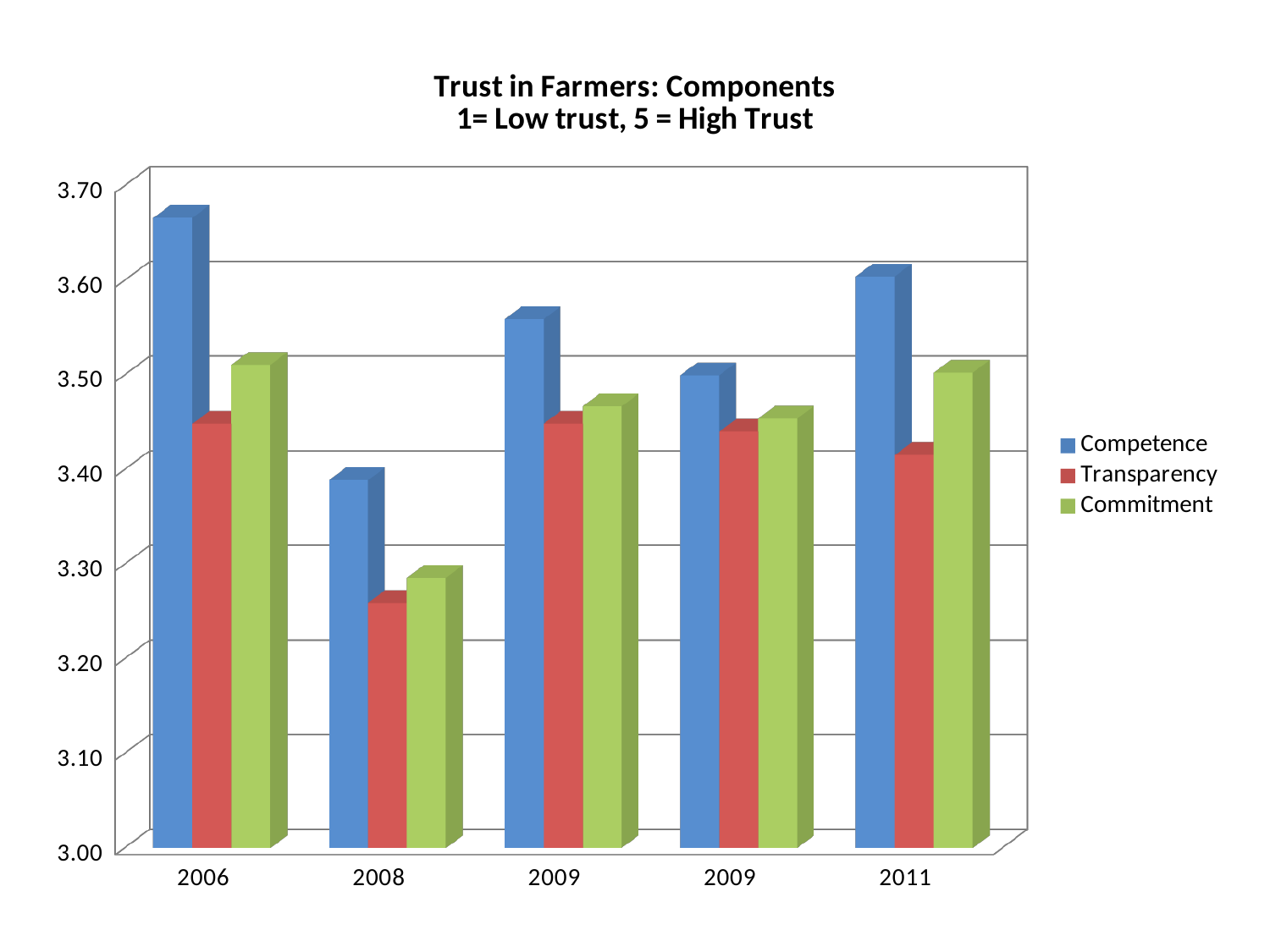
In which year is the Transparency value lowest? 2008 Is the Transparency value for 2008 greater or less than 3.30? less Is the Competence value for 2008 greater or less than 3.50? less Which is larger, the Competence value for 2006 or the Competence value for 2011? 2006 In which year is the Competence value highest? 2006 Does the Competence value rise or fall from 2006 to 2008? fall What kind of chart is shown on the slide? bar chart Which component has the lowest value in 2008? Transparency How many year categories are shown on the x axis? 5 How many series does the legend list? 3 Which component has the highest value in 2006? Competence Is the Competence value for 2006 greater or less than 3.60? greater